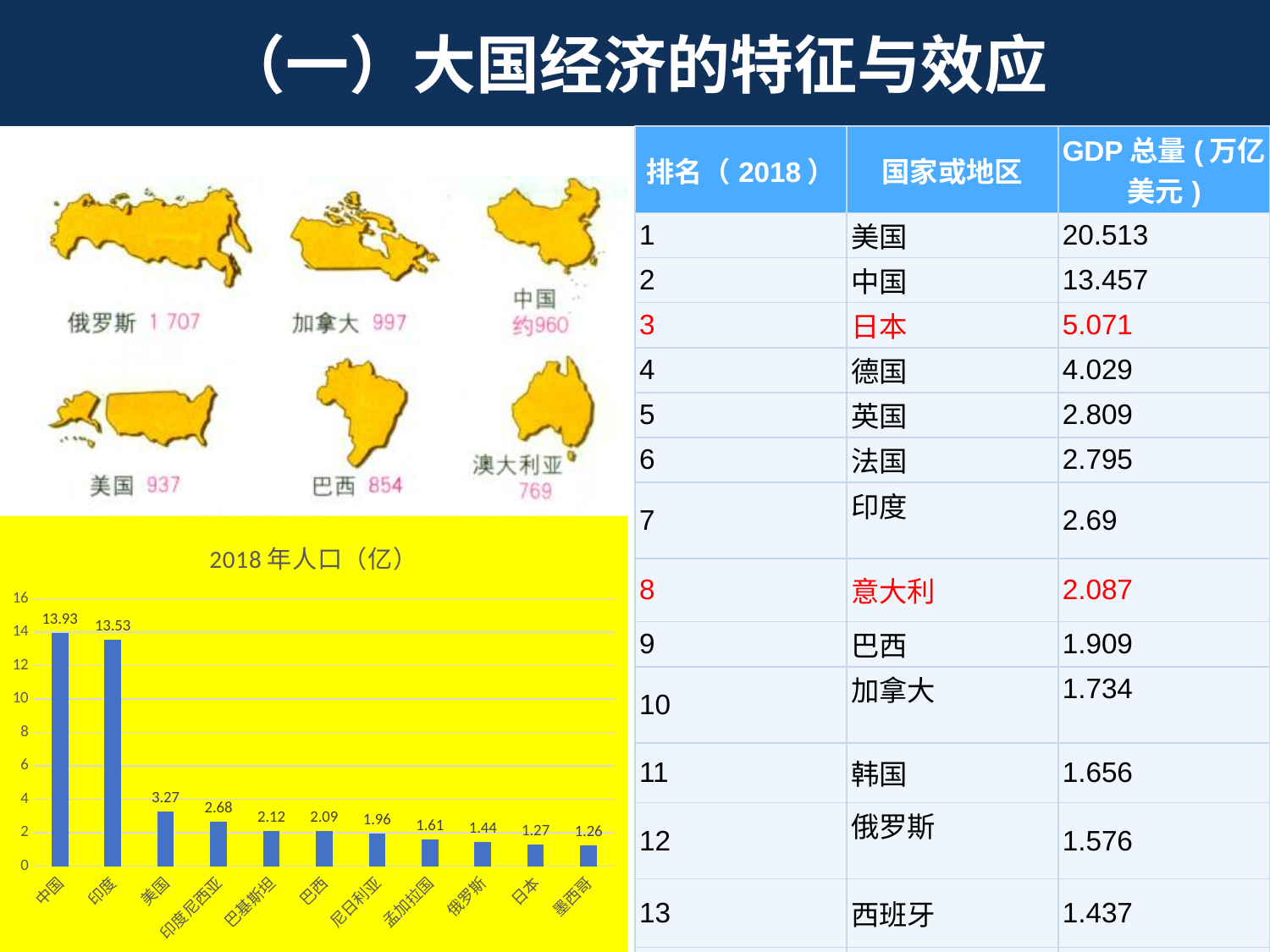
What kind of chart is the one titled 2018年人口（亿）? bar chart In the chart titled 2018年人口（亿）, what is the difference between the values for 美国 and 印度尼西亚? 0.59 In the chart titled 2018年人口（亿）, which category has the highest value? 中国 In the chart titled 2018年人口（亿）, what is the value for 巴基斯坦? 2.12 In the chart titled 2018年人口（亿）, is the value for 印度 greater or less than 12? greater How many categories are shown in the chart titled 2018年人口（亿）? 11 In the chart titled 2018年人口（亿）, which category has the lowest value? 墨西哥 In the chart titled 2018年人口（亿）, do the values rise or fall from left to right along the x axis? fall In the chart titled 2018年人口（亿）, what is the value for 美国? 3.27 In the chart titled 2018年人口（亿）, which is larger, the value for 尼日利亚 or the value for 俄罗斯? 尼日利亚 In the chart titled 2018年人口（亿）, what is the difference between the values for 中国 and 印度? 0.40 In the chart titled 2018年人口（亿）, what is the value for 中国? 13.93